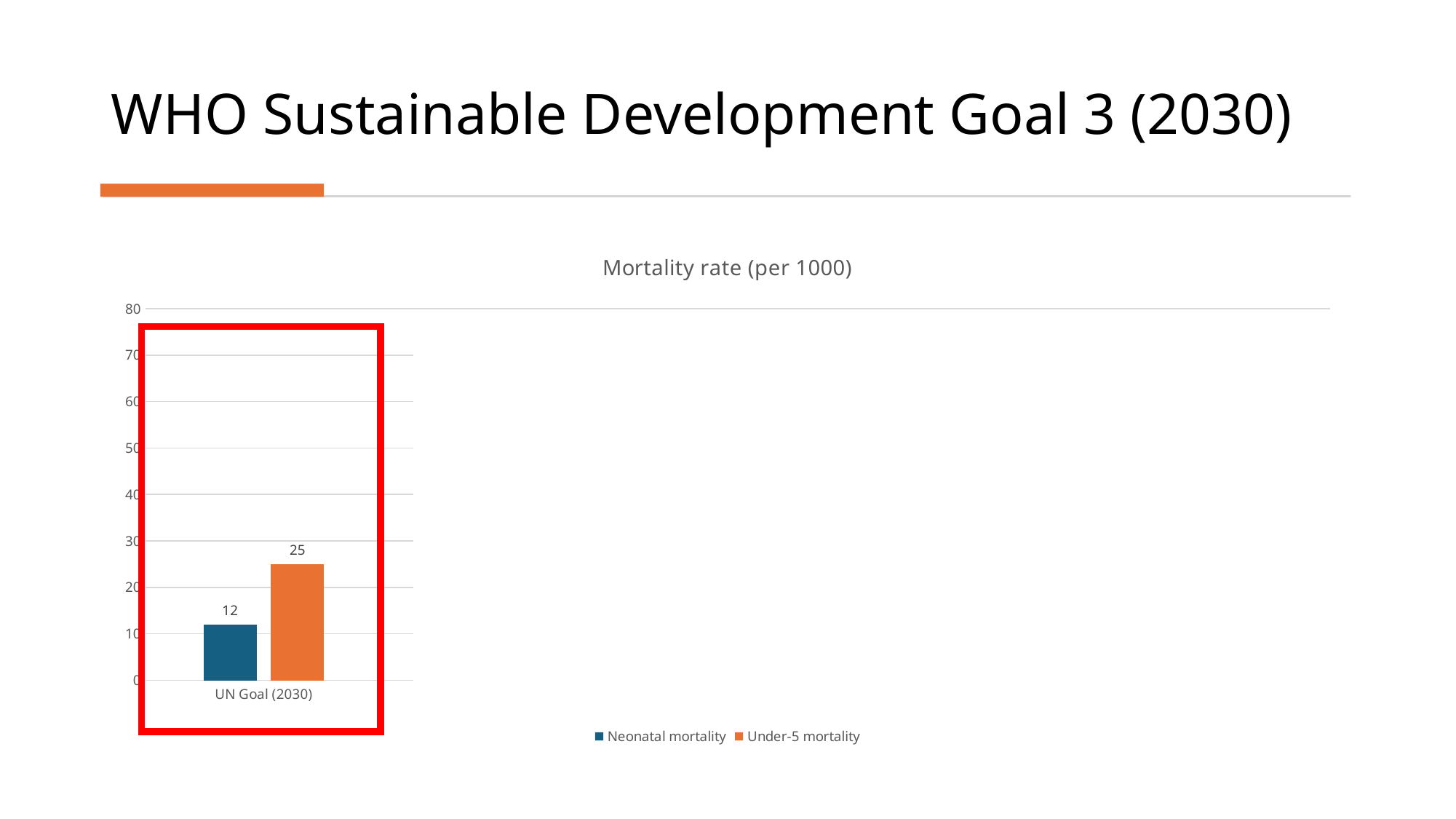
What is the Neonatal mortality value for UN Goal (2030)? 12 What is the highest value shown on the y axis of the chart? 80 How many series does the legend list? 2 What is the Under-5 mortality value for UN Goal (2030)? 25 Is the Under-5 mortality value for UN Goal (2030) greater or less than 20? greater What kind of chart is shown on the slide? bar chart What is the difference between the Under-5 mortality and Neonatal mortality values for UN Goal (2030)? 13 Which series has the higher value for UN Goal (2030), Neonatal mortality or Under-5 mortality? Under-5 mortality Which series is shown in orange in the chart? Under-5 mortality How many categories are shown on the x axis of the chart? 1 Is the Neonatal mortality value for UN Goal (2030) greater or less than 20? less What is the title of the chart? Mortality rate (per 1000)